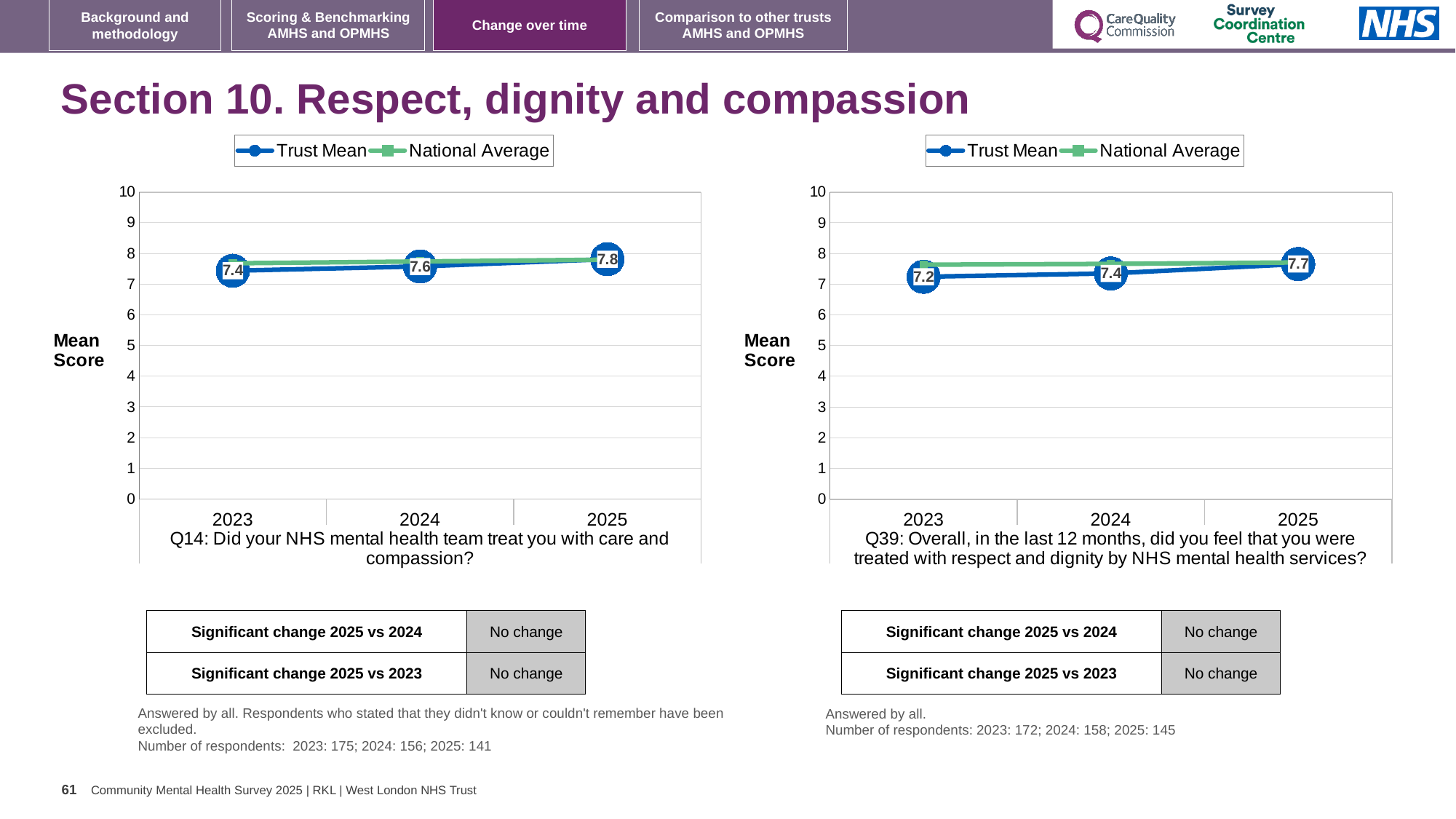
In the Q39 chart on the right, which year has the lowest Trust Mean score? 2023 In the Q14 chart on the left, which year has the highest Trust Mean score? 2025 In the Q39 chart on the right, what is the Trust Mean score for 2023? 7.2 In the Q39 chart on the right, does the Trust Mean rise or fall from 2023 to 2025? Rise How many years are plotted on the x axis of the Q14 chart on the left? 3 In the Q14 chart on the left, what is the Trust Mean score for 2025? 7.8 Which is larger: the 2024 Trust Mean in the Q14 chart on the left or the 2024 Trust Mean in the Q39 chart on the right? Q14 chart (7.6) In the Q39 chart on the right, is the National Average value for 2025 greater or less than 7? greater In the Q14 chart on the left, what is the difference between the Trust Mean scores for 2025 and 2023? 0.4 In the Q39 chart on the right, what is the difference between the Trust Mean scores for 2025 and 2024? 0.3 How many series does the legend of the Q39 chart on the right list? 2 What kind of chart is the Q14 chart on the left? Line chart